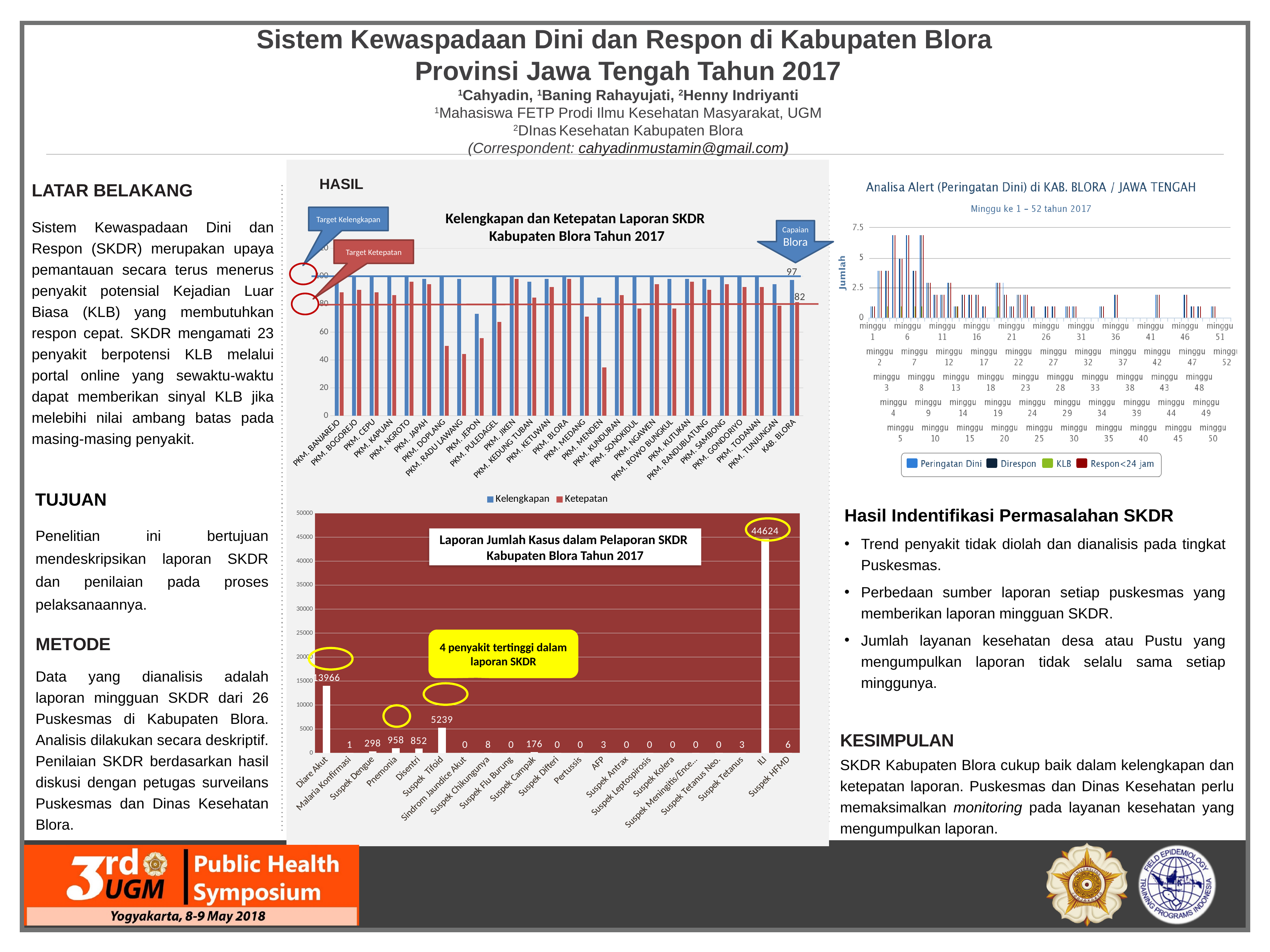
In the chart 'Laporan Jumlah Kasus dalam Pelaporan SKDR Kabupaten Blora Tahun 2017', what is the value for ILI? 44624 What kind of chart is 'Laporan Jumlah Kasus dalam Pelaporan SKDR Kabupaten Blora Tahun 2017'? bar chart In the chart 'Laporan Jumlah Kasus dalam Pelaporan SKDR Kabupaten Blora Tahun 2017', what is the value for Suspek Campak? 176 In the chart 'Laporan Jumlah Kasus dalam Pelaporan SKDR Kabupaten Blora Tahun 2017', which is larger, Pnemonia or Disentri? Pnemonia In the chart 'Kelengkapan dan Ketepatan Laporan SKDR Kabupaten Blora Tahun 2017', what is the Kelengkapan value for KAB. BLORA? 97 In the chart 'Laporan Jumlah Kasus dalam Pelaporan SKDR Kabupaten Blora Tahun 2017', what is the value for Suspek Tifoid? 5239 In the chart 'Kelengkapan dan Ketepatan Laporan SKDR Kabupaten Blora Tahun 2017', what is the Ketepatan value for KAB. BLORA? 82 In the chart 'Laporan Jumlah Kasus dalam Pelaporan SKDR Kabupaten Blora Tahun 2017', which category has the highest value? ILI How many series does the legend of the chart 'Analisa Alert (Peringatan Dini) di KAB. BLORA / JAWA TENGAH' list? 4 In the chart 'Laporan Jumlah Kasus dalam Pelaporan SKDR Kabupaten Blora Tahun 2017', what is the value for Diare Akut? 13966 In the chart 'Laporan Jumlah Kasus dalam Pelaporan SKDR Kabupaten Blora Tahun 2017', what is the difference between the values for ILI and Diare Akut? 30658 In the chart 'Kelengkapan dan Ketepatan Laporan SKDR Kabupaten Blora Tahun 2017', is the Ketepatan value for PKM. RADU LAWANG greater or less than 60? less